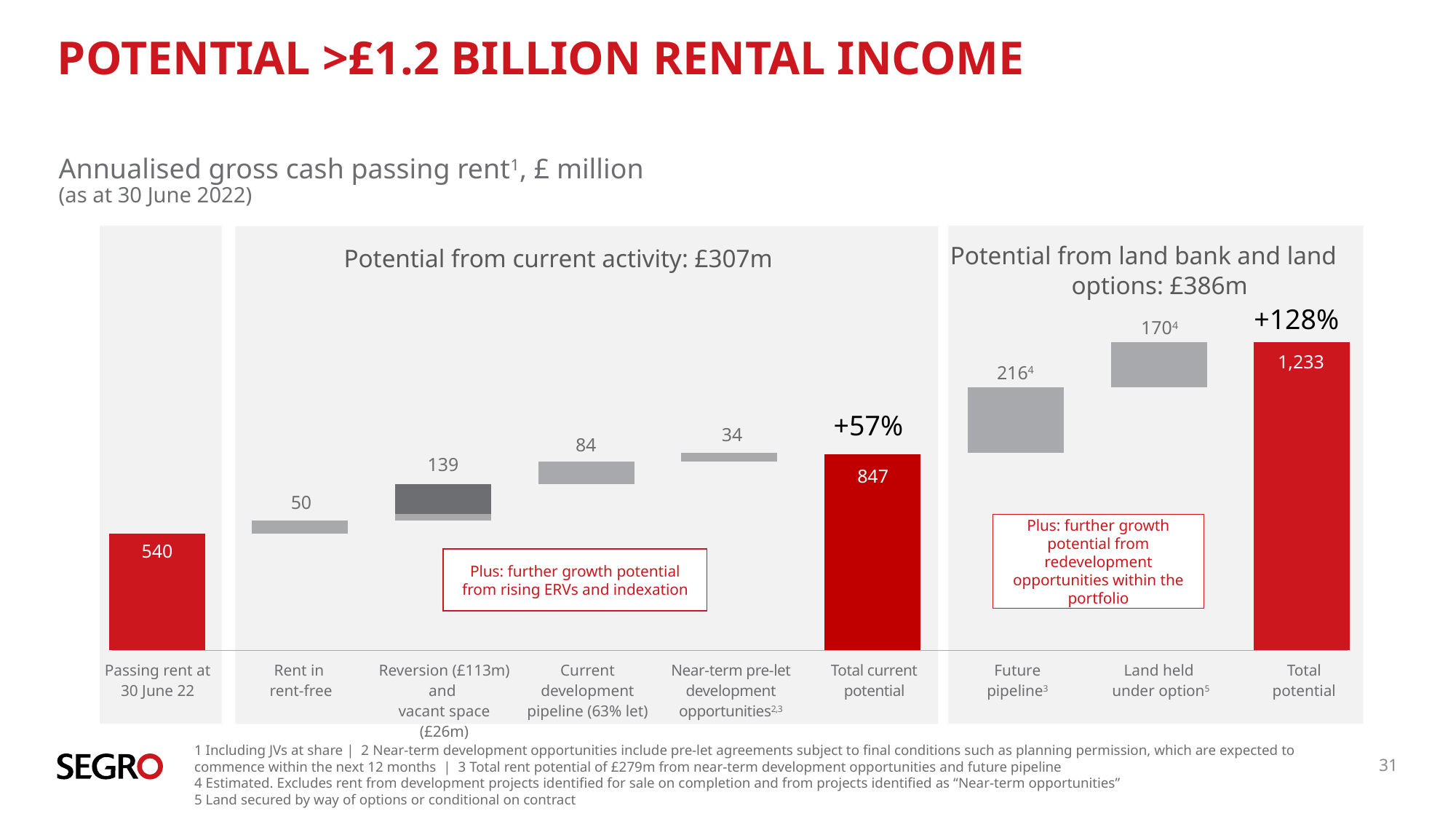
What percentage increase is shown above the Total current potential bar? +57% Which is larger, the value for Future pipeline or the value for Land held under option? Future pipeline What value is shown for Reversion and vacant space? 139 What value is shown for the Current development pipeline (63% let)? 84 What is the Total potential shown on the chart? 1,233 What is the potential from land bank and land options stated in the chart heading? £386m What is the Total current potential shown on the chart? 847 What value is shown for Land held under option? 170 Which category has the smallest value on the chart? Near-term pre-let development opportunities What is the difference between Total potential and Total current potential? 386 What is the passing rent at 30 June 22 shown on the chart? 540 What value is shown for Rent in rent-free? 50